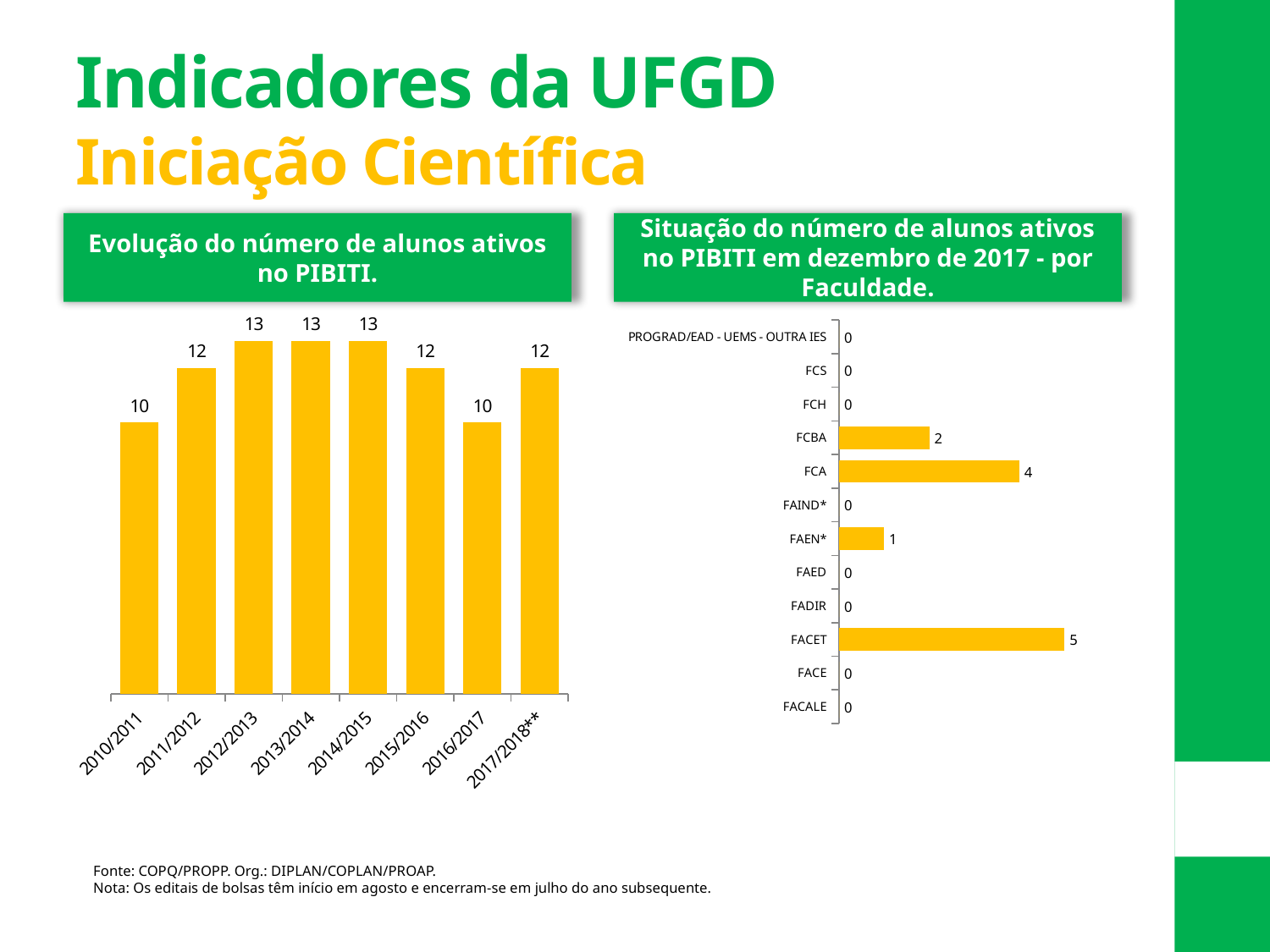
In the chart 'Evolução do número de alunos ativos no PIBITI', what is the value for 2015/2016? 12 In the chart 'Situação do número de alunos ativos no PIBITI em dezembro de 2017 - por Faculdade', what is the value for FAEN*? 1 In the chart 'Situação do número de alunos ativos no PIBITI em dezembro de 2017 - por Faculdade', which faculty has the highest value? FACET In the chart 'Situação do número de alunos ativos no PIBITI em dezembro de 2017 - por Faculdade', what is the difference between the values for FACET and FCBA? 3 In the chart 'Evolução do número de alunos ativos no PIBITI', what is the difference between the values for 2012/2013 and 2016/2017? 3 In the chart 'Evolução do número de alunos ativos no PIBITI', what kind of chart is it? Bar chart In the chart 'Evolução do número de alunos ativos no PIBITI', do the values rise or fall from 2010/2011 to 2012/2013? Rise In the chart 'Evolução do número de alunos ativos no PIBITI', how many periods are shown on the x axis? 8 In the chart 'Situação do número de alunos ativos no PIBITI em dezembro de 2017 - por Faculdade', how many categories are listed? 12 In the chart 'Evolução do número de alunos ativos no PIBITI', which is larger, the value for 2011/2012 or the value for 2016/2017? 2011/2012 In the chart 'Situação do número de alunos ativos no PIBITI em dezembro de 2017 - por Faculdade', what is the value for FCA? 4 In the chart 'Evolução do número de alunos ativos no PIBITI', what is the value for 2010/2011? 10